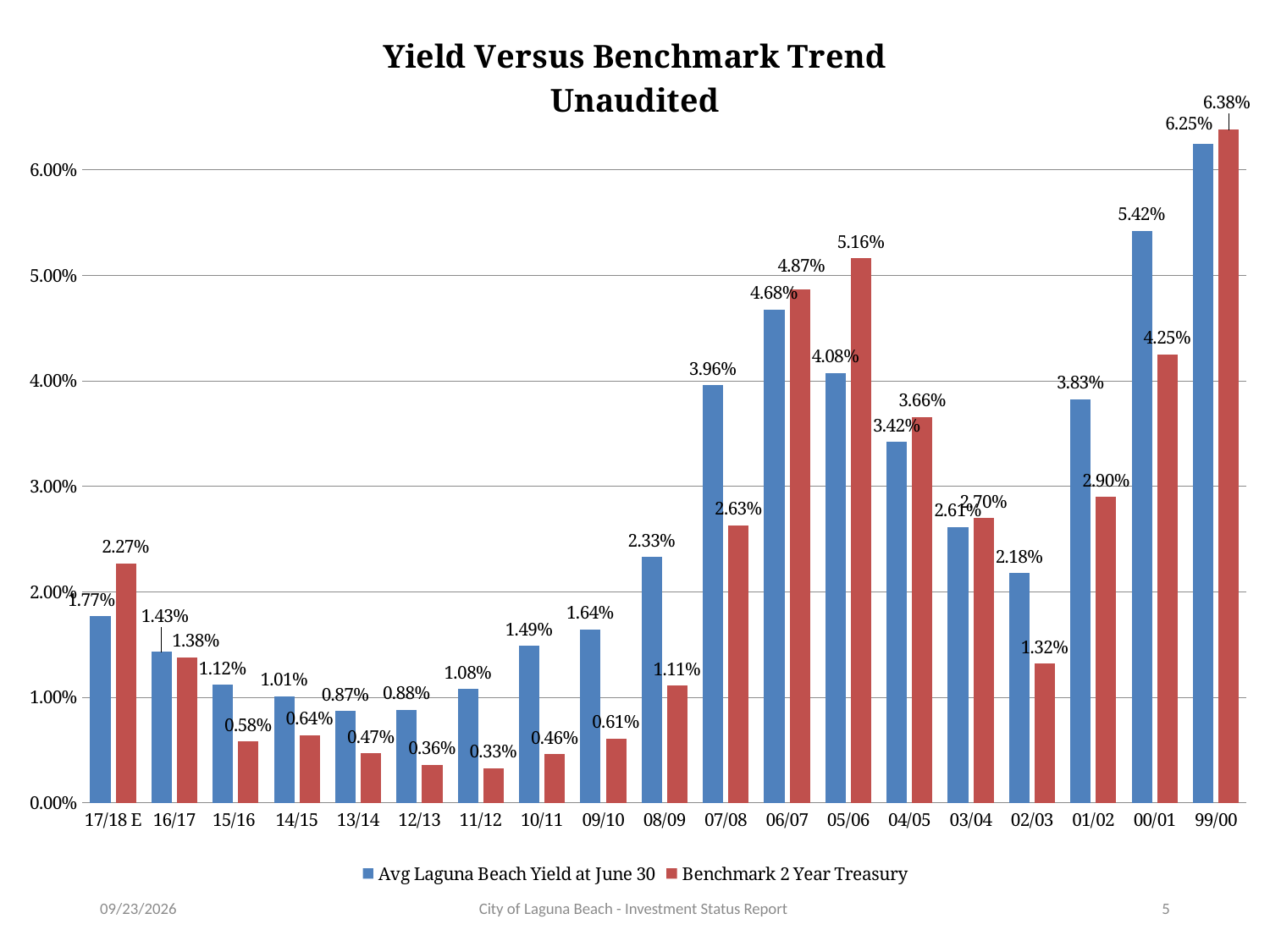
Which fiscal year has the lowest Benchmark 2 Year Treasury value? 11/12 What kind of chart is shown on the slide? Bar chart For 08/09, which is larger: the Avg Laguna Beach Yield at June 30 or the Benchmark 2 Year Treasury? Avg Laguna Beach Yield at June 30 Which fiscal year has the highest Avg Laguna Beach Yield at June 30? 99/00 What is the difference between the Avg Laguna Beach Yield at June 30 and the Benchmark 2 Year Treasury for 00/01? 1.17% What is the Benchmark 2 Year Treasury value for 11/12? 0.33% What is the difference between the Benchmark 2 Year Treasury and the Avg Laguna Beach Yield at June 30 for 05/06? 1.08% How many series does the legend list? 2 What is the Avg Laguna Beach Yield at June 30 for 17/18 E? 1.77% Is the Avg Laguna Beach Yield at June 30 for 07/08 greater or less than 3.00%? greater What is the Benchmark 2 Year Treasury value for 05/06? 5.16% How many fiscal years are shown on the x axis? 19